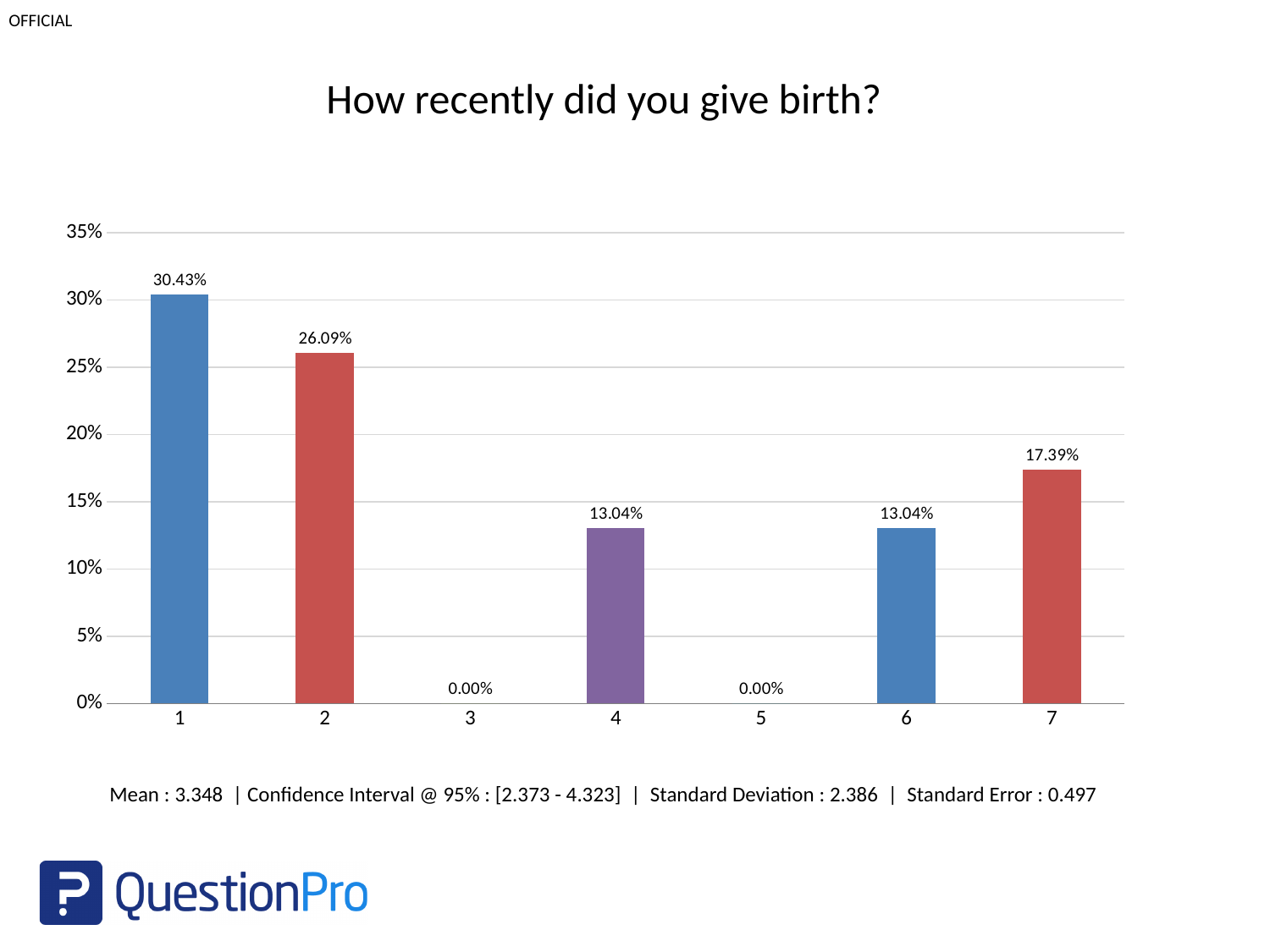
Which is larger, the value for category 2 or the value for category 7? 2 What is the difference between the values for category 1 and category 2? 4.34% What is the value for category 1? 30.43% What is the title of the chart? How recently did you give birth? What is the value for category 3? 0.00% Is the value for category 4 greater or less than 15%? less What is the mean value reported below the chart? 3.348 Which category has the highest value? 1 What kind of chart is shown on the slide? bar chart How many categories have a value of 0.00%? 2 What is the value for category 7? 17.39% How many categories are shown on the x axis? 7